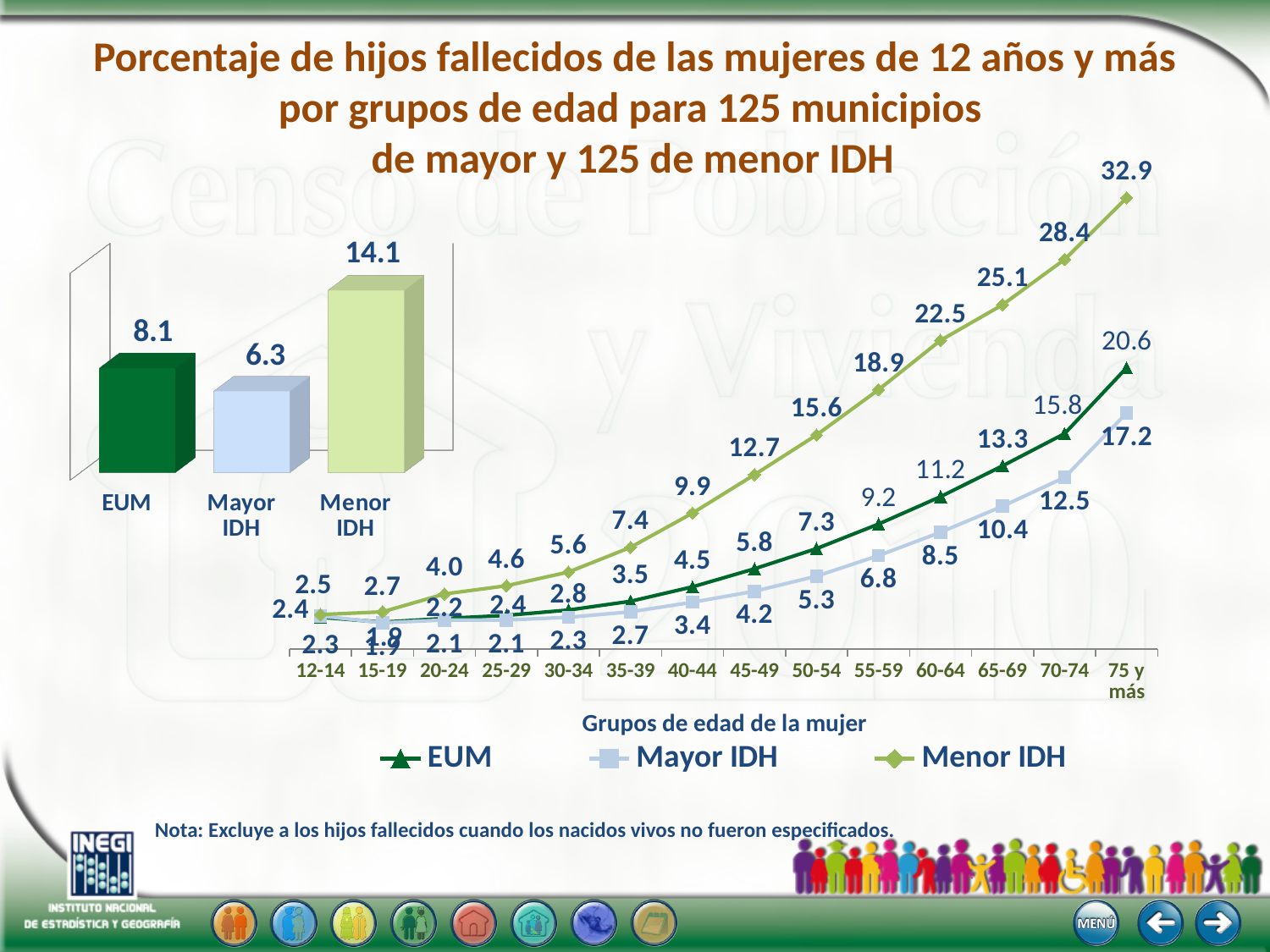
In the line chart on the right, which series has the highest value for the 70-74 age group? Menor IDH In the line chart on the right, what is the Menor IDH value for the 75 y más age group? 32.9 In the line chart on the right, what is the EUM value for the 50-54 age group? 7.3 In the line chart on the right, is the Menor IDH value for 45-49 larger or smaller than the EUM value for 45-49? larger In the bar chart on the left, what is the value for Menor IDH? 14.1 In the bar chart on the left, how many categories are shown? 3 In the line chart on the right, what is the difference between the Menor IDH and Mayor IDH values for the 75 y más age group? 15.7 In the line chart on the right, what is the Mayor IDH value for the 60-64 age group? 8.5 In the bar chart on the left, what is the difference between the Menor IDH and EUM values? 6.0 In the bar chart on the left, which category has the lowest value? Mayor IDH In the line chart on the right, do the Menor IDH values rise or fall from the 20-24 group to the 75 y más group? rise In the line chart on the right, how many series does the legend list? 3